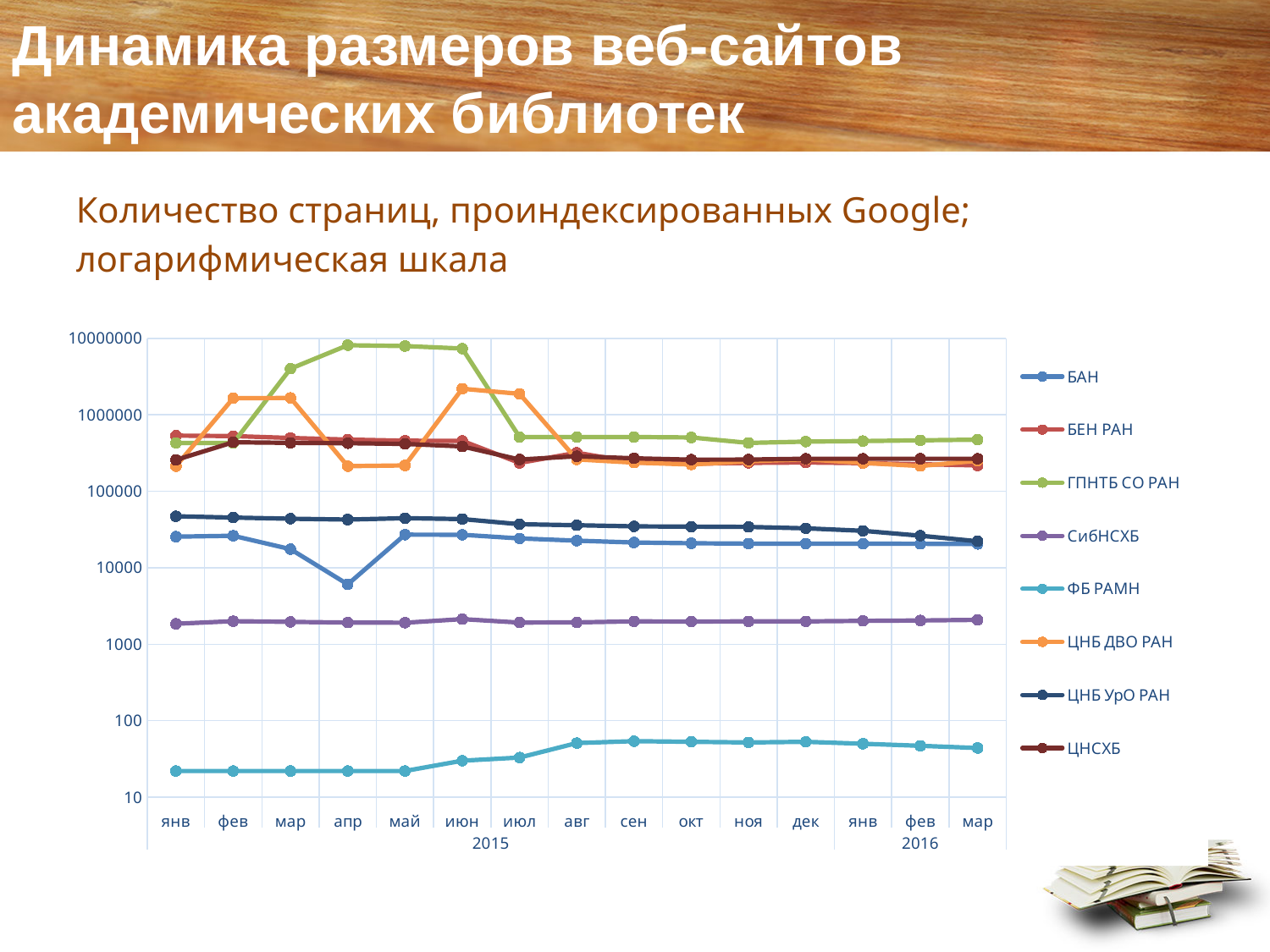
Which series has the lowest values across the whole period? ФБ РАМН Is the value for СибНСХБ in сен 2015 greater or less than 1000? greater Which series has the highest value in апр 2015? ГПНТБ СО РАН How many series does the legend list? 8 Is the value for БАН in апр 2015 greater or less than 10000? less In апр 2015, which is larger: the value for ЦНБ УрО РАН or the value for БАН? ЦНБ УрО РАН Does the value for ФБ РАМН rise or fall from янв 2015 to сен 2015? rise Is the value for ГПНТБ СО РАН in апр 2015 greater or less than 1000000? greater What kind of scale does the vertical axis of the chart use? logarithmic What kind of chart is shown on the slide? line chart How many monthly points are plotted along the x axis? 15